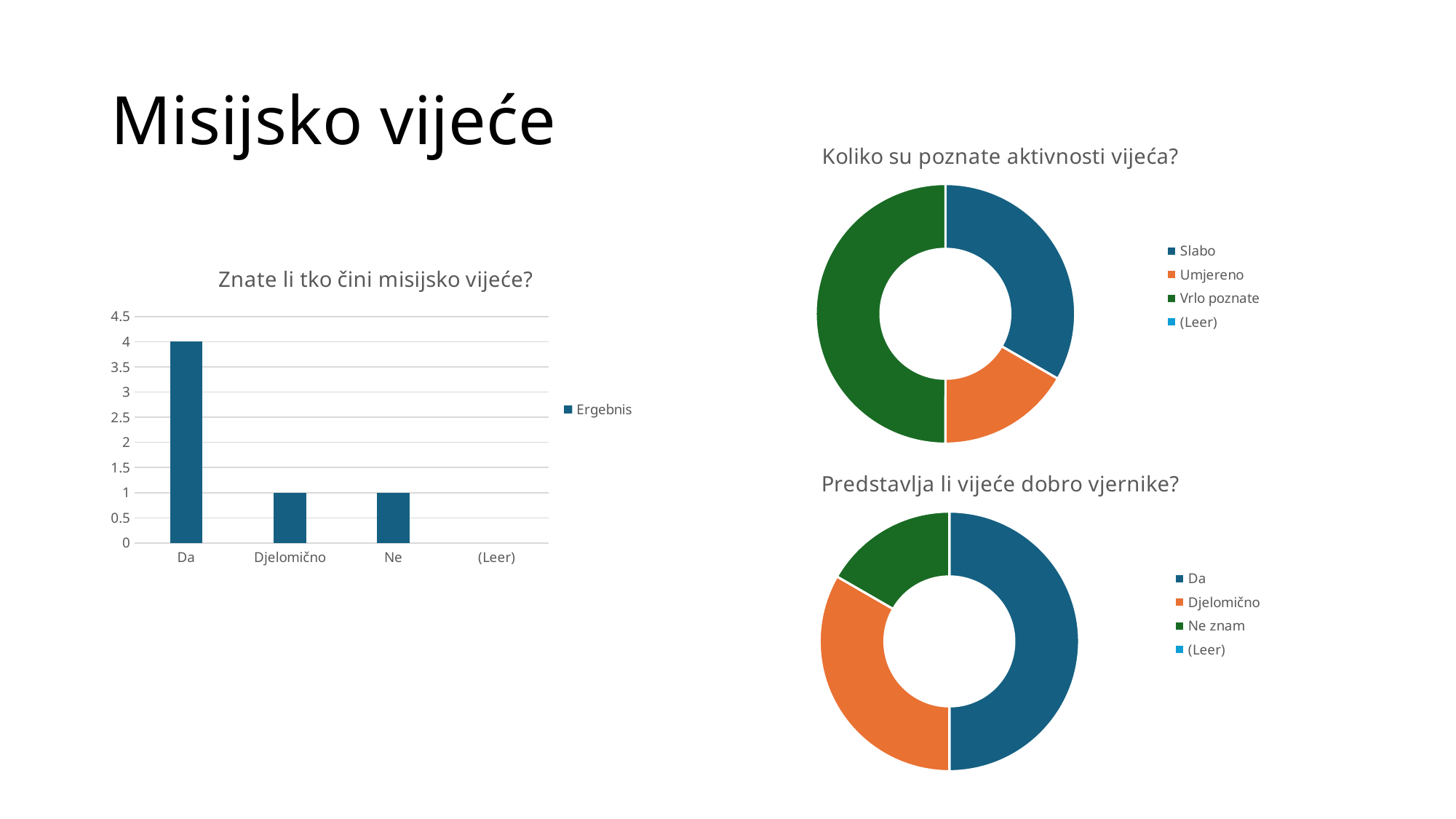
In the chart titled "Znate li tko čini misijsko vijeće?", which category has the highest value? Da In the chart titled "Znate li tko čini misijsko vijeće?", what is the value for Da? 4 In the chart titled "Znate li tko čini misijsko vijeće?", what is the difference between the values for Da and Djelomično? 3 In the chart titled "Znate li tko čini misijsko vijeće?", how many categories are shown on the x axis? 4 In the chart titled "Predstavlja li vijeće dobro vjernike?", which category has the largest slice? Da In the chart titled "Koliko su poznate aktivnosti vijeća?", which category has the largest slice? Vrlo poznate In the chart titled "Znate li tko čini misijsko vijeće?", is the value for Da greater or less than 3? greater In the chart titled "Koliko su poznate aktivnosti vijeća?", which slice is larger, Slabo or Umjereno? Slabo In the chart titled "Znate li tko čini misijsko vijeće?", what series name does the legend show? Ergebnis What kind of chart is "Znate li tko čini misijsko vijeće?"? bar chart In the chart titled "Znate li tko čini misijsko vijeće?", what is the value for Ne? 1 How many entries does the legend of the chart titled "Predstavlja li vijeće dobro vjernike?" list? 4